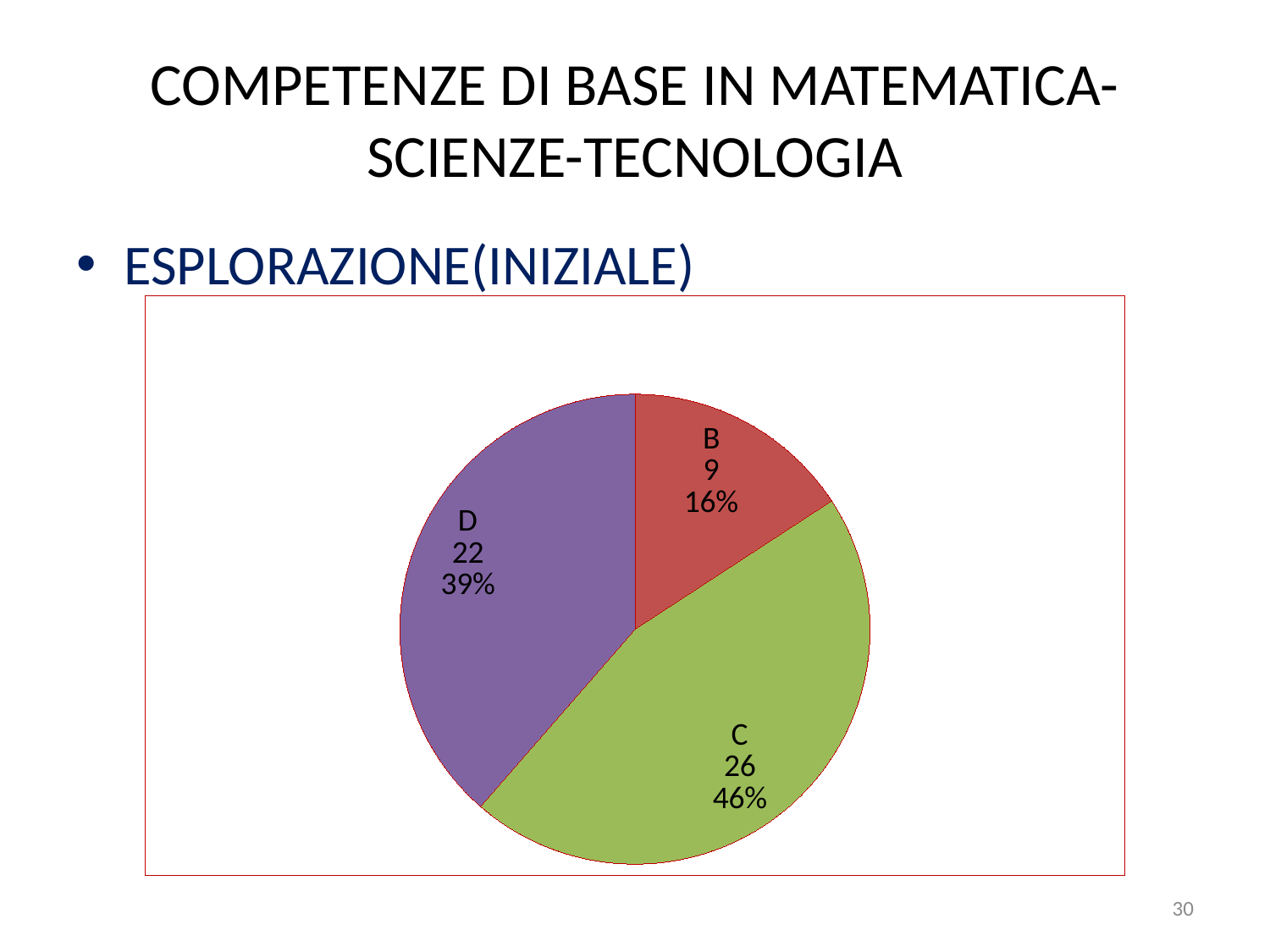
Which slice is the largest? C What percentage share does slice D have? 39% What is the value for slice D? 22 Which slice is the smallest? B What percentage share does slice C have? 46% What percentage share does slice B have? 16% How many slices does the pie chart have? 3 Which is larger, slice D or slice B? D What is the value for slice C? 26 What is the difference between the values of slices C and D? 4 What kind of chart is shown on the slide? pie chart What is the value for slice B? 9